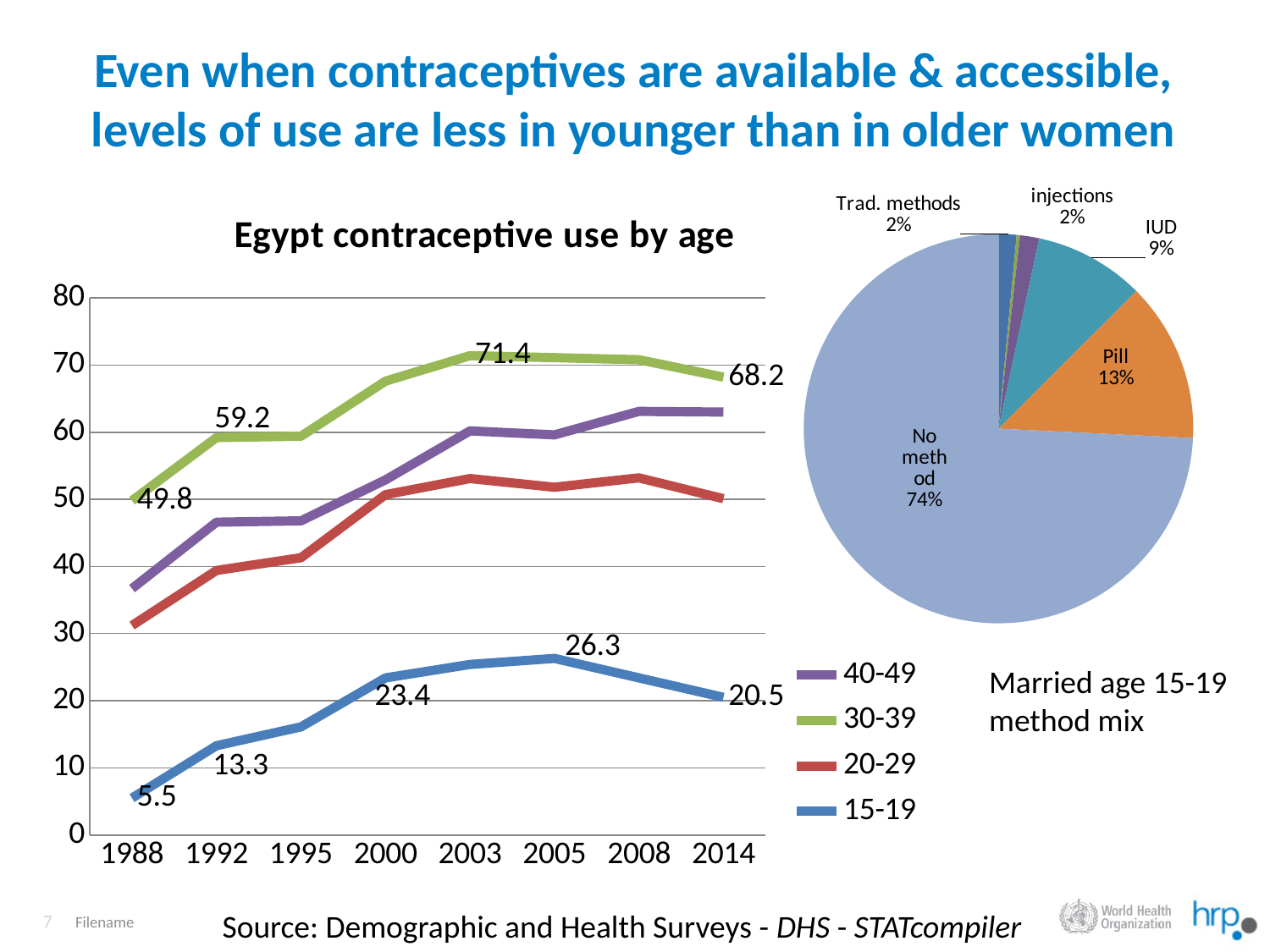
In the 'Egypt contraceptive use by age' chart, which age group has the highest values across the years? 30-39 How many series does the legend of the 'Egypt contraceptive use by age' chart list? 4 In the 'Egypt contraceptive use by age' chart, is the value for the 40-49 series in 2014 greater or less than 60? greater In the 'Egypt contraceptive use by age' chart, what is the value for the 15-19 series in 2014? 20.5 In the 'Egypt contraceptive use by age' chart, what is the value for the 30-39 series in 2003? 71.4 In the 'Egypt contraceptive use by age' chart, what is the difference between the 30-39 value in 1992 and the 30-39 value in 1988? 9.4 In the 'Egypt contraceptive use by age' chart, what is the value for the 15-19 series in 1988? 5.5 In the 'Married age 15-19 method mix' pie chart, which of Pill or IUD has the larger share? Pill In the 'Egypt contraceptive use by age' chart, which age group has the lowest values across the years? 15-19 In the 'Married age 15-19 method mix' pie chart, what share is 'No method'? 74% What kind of chart is 'Egypt contraceptive use by age'? Line chart How many years are shown on the x axis of the 'Egypt contraceptive use by age' chart? 8